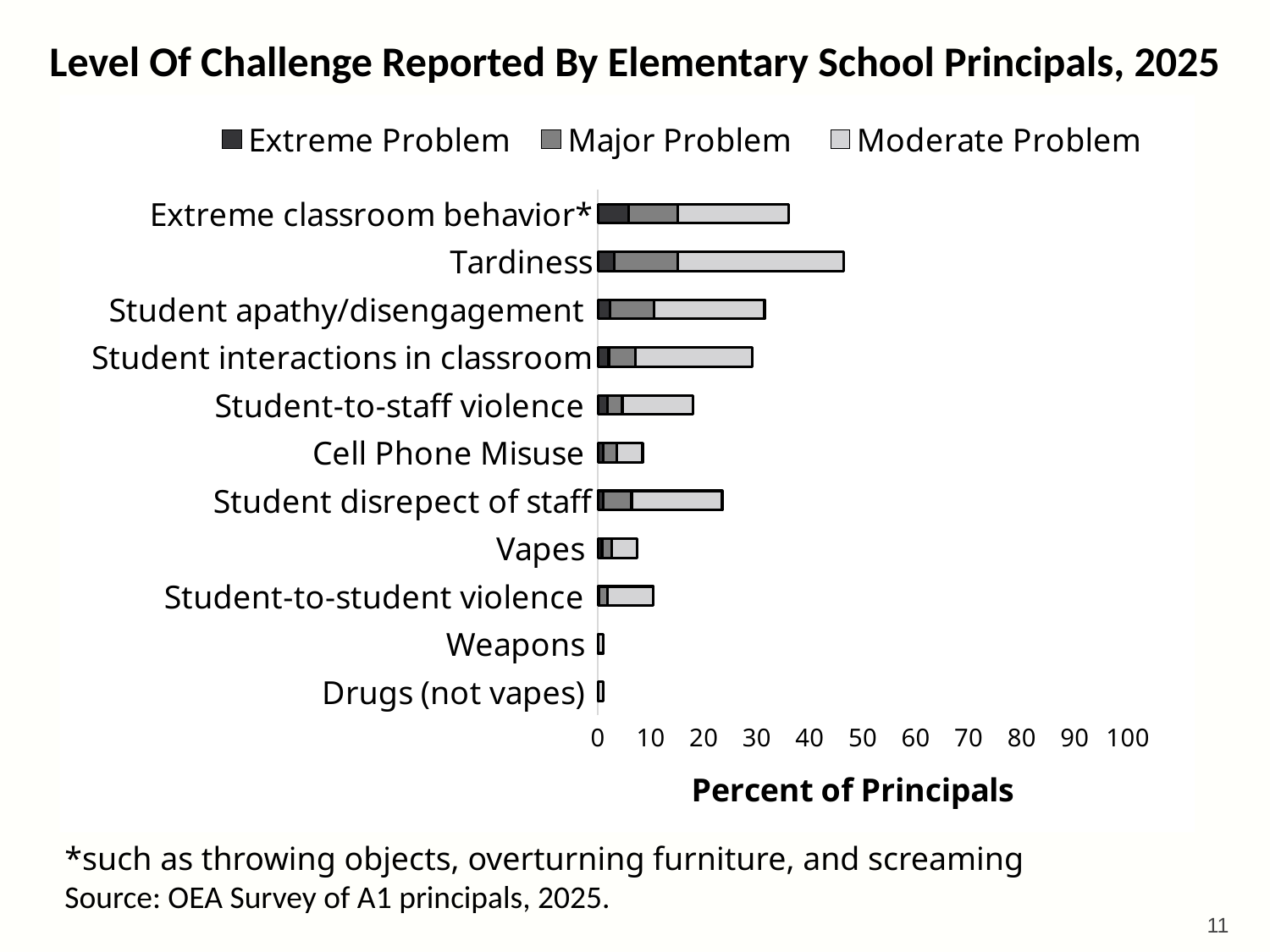
What are the three series named in the legend? Extreme Problem, Major Problem, Moderate Problem Is the total bar for Vapes greater or less than 10? less Is the total bar for Student-to-student violence greater or less than 20? less How many categories (challenges) are listed on the chart? 11 How many series does the legend list? 3 Which has a longer total bar, Tardiness or Extreme classroom behavior*? Tardiness Which has a longer total bar, Student apathy/disengagement or Student-to-staff violence? Student apathy/disengagement Is the total bar for Tardiness greater or less than 40? greater Which challenge has the longest total bar? Tardiness What kind of chart is shown on the slide? Stacked bar chart What is the title of the horizontal axis? Percent of Principals